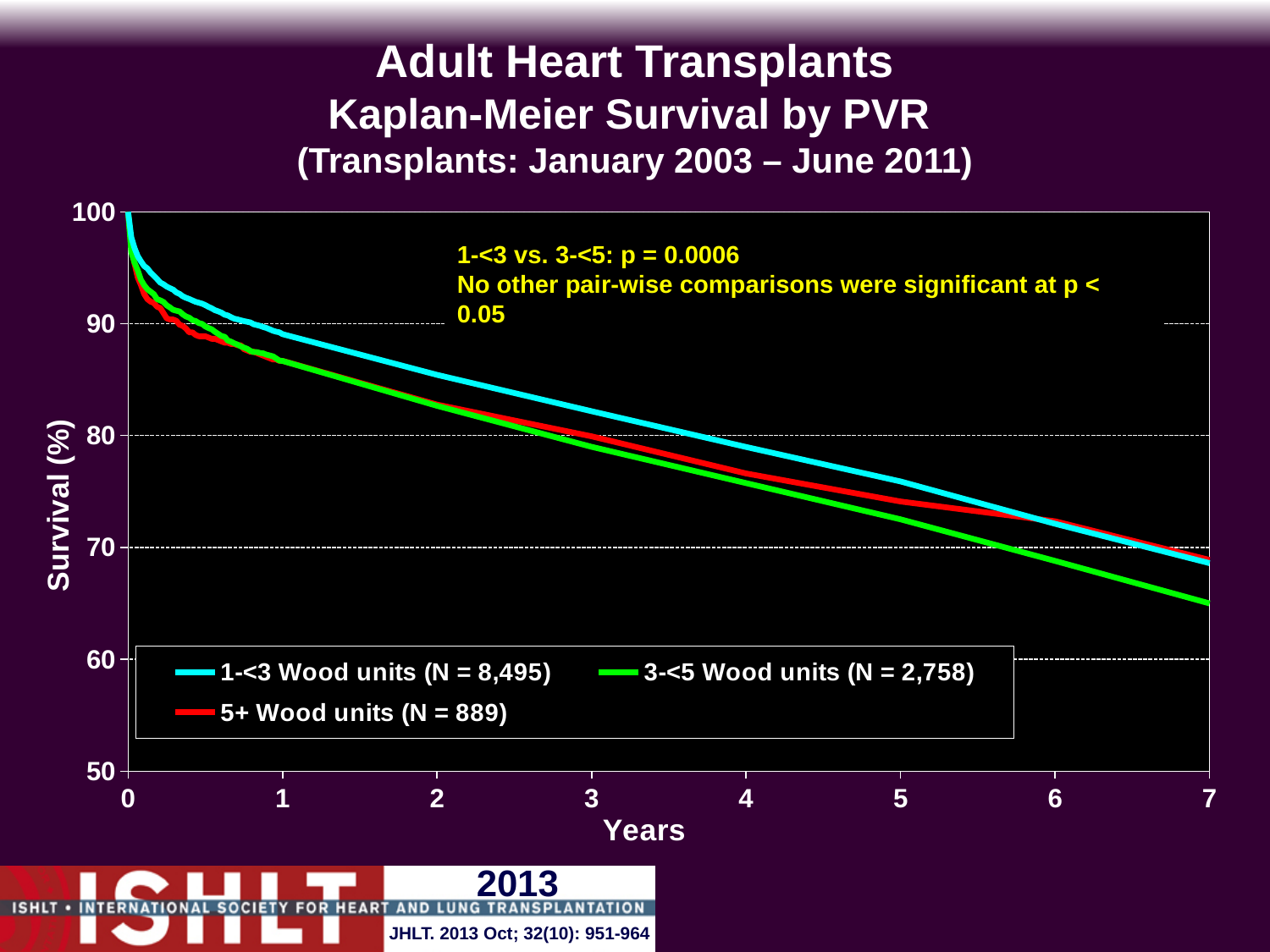
Which group has the lowest survival at year 7? 3-<5 Wood units Do the survival curves rise or fall as years increase? fall What is the N for the 1-<3 Wood units group shown in the legend? 8,495 What kind of chart is shown on the slide? line chart Is the survival value for 1-<3 Wood units at year 3 greater or less than 80? greater Is the survival value for 3-<5 Wood units at year 7 greater or less than 70? less Is the survival value for 3-<5 Wood units at year 5 greater or less than 70? greater What p-value is given for the 1-<3 vs. 3-<5 comparison? p = 0.0006 At year 4, which has higher survival: 1-<3 Wood units or 3-<5 Wood units? 1-<3 Wood units How many series does the legend list? 3 At year 7, which has higher survival: 1-<3 Wood units or 3-<5 Wood units? 1-<3 Wood units